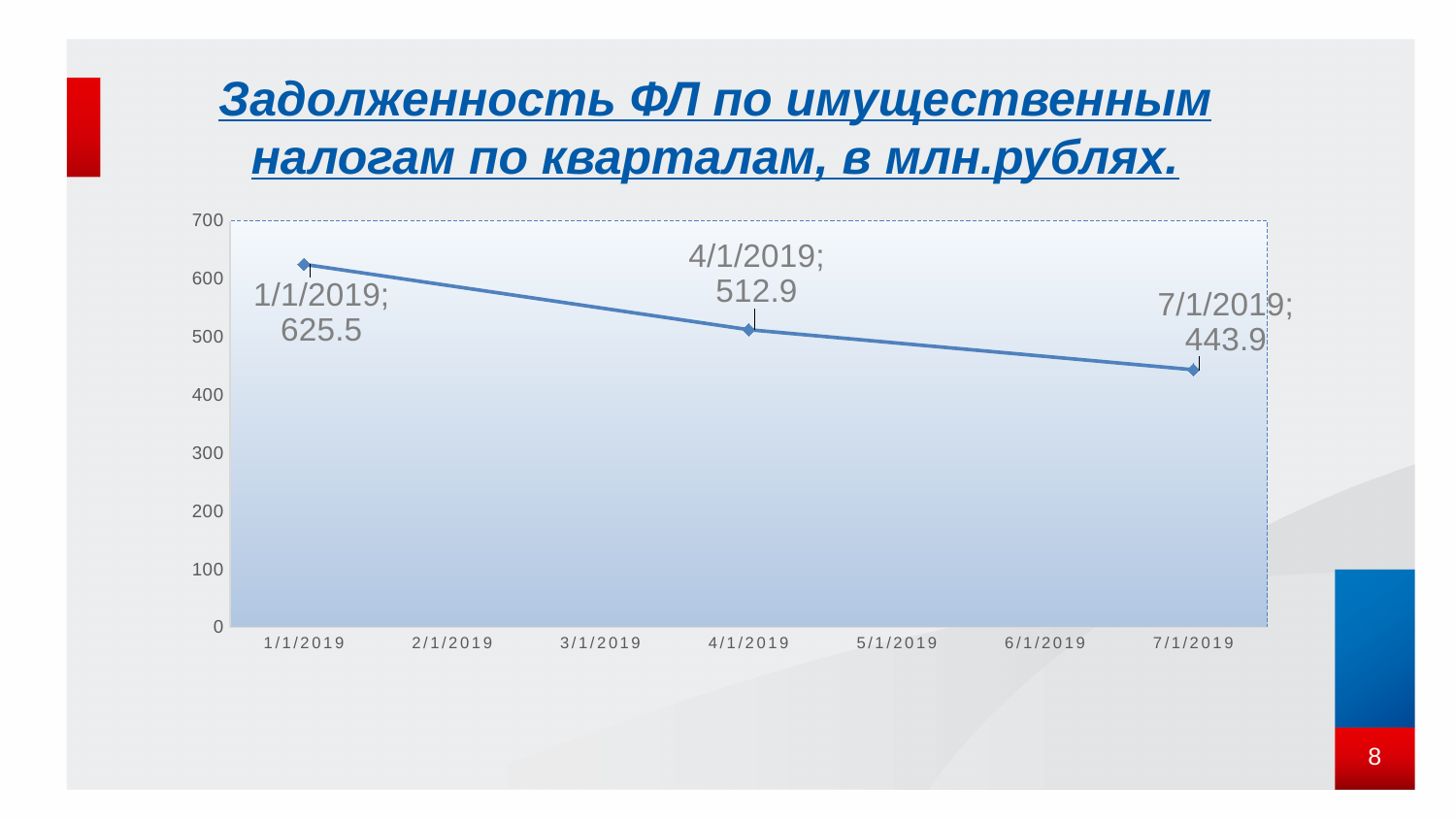
Is the value for 7/1/2019 greater or less than 500? less What is the difference between the values for 1/1/2019 and 4/1/2019? 112.6 Which is larger, the value for 4/1/2019 or the value for 7/1/2019? 4/1/2019 What kind of chart is shown on the slide? line chart What is the value for 4/1/2019? 512.9 Which date has the lowest value? 7/1/2019 What is the difference between the values for 1/1/2019 and 7/1/2019? 181.6 Which date has the highest value? 1/1/2019 What is the value for 1/1/2019? 625.5 Do the values rise or fall from 1/1/2019 to 7/1/2019? fall What is the value for 7/1/2019? 443.9 How many data points are plotted on the line? 3